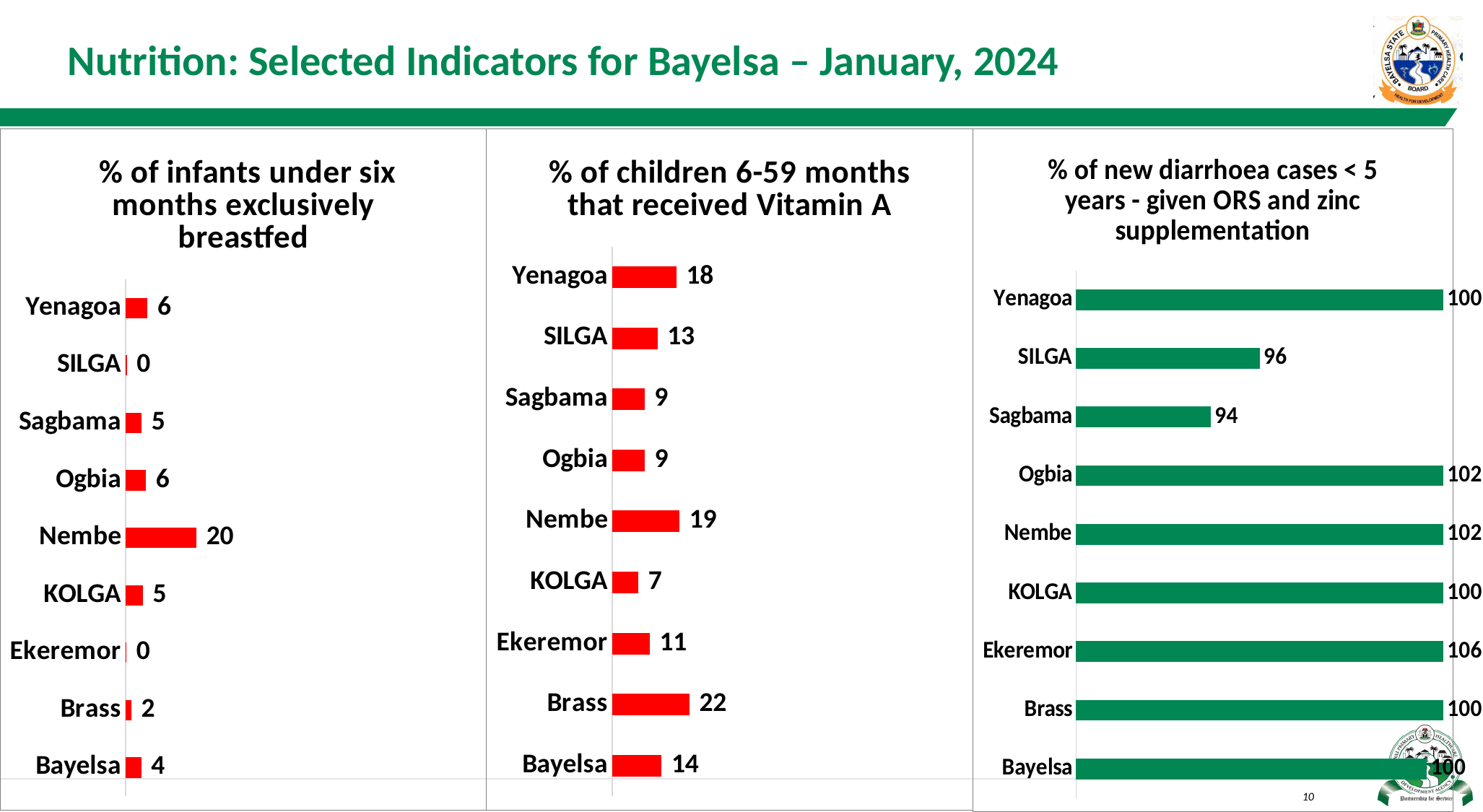
In the '% of new diarrhoea cases < 5 years - given ORS and zinc supplementation' chart, which category has the lowest value? Sagbama In the '% of infants under six months exclusively breastfed' chart, what is the value for Nembe? 20 In the '% of new diarrhoea cases < 5 years - given ORS and zinc supplementation' chart, what is the difference between Ekeremor and Sagbama? 12 In the '% of infants under six months exclusively breastfed' chart, what is the value for Bayelsa? 4 What kind of chart is the '% of new diarrhoea cases < 5 years - given ORS and zinc supplementation' chart? Bar chart In the '% of children 6-59 months that received Vitamin A' chart, which is larger, Yenagoa or Ekeremor? Yenagoa In the '% of children 6-59 months that received Vitamin A' chart, what is the value for Brass? 22 In the '% of children 6-59 months that received Vitamin A' chart, what is the difference between Brass and SILGA? 9 In the '% of children 6-59 months that received Vitamin A' chart, which category has the lowest value? KOLGA In the '% of infants under six months exclusively breastfed' chart, which category has the highest value? Nembe In the '% of new diarrhoea cases < 5 years - given ORS and zinc supplementation' chart, what is the value for Ekeremor? 106 How many categories are shown in the '% of children 6-59 months that received Vitamin A' chart? 9